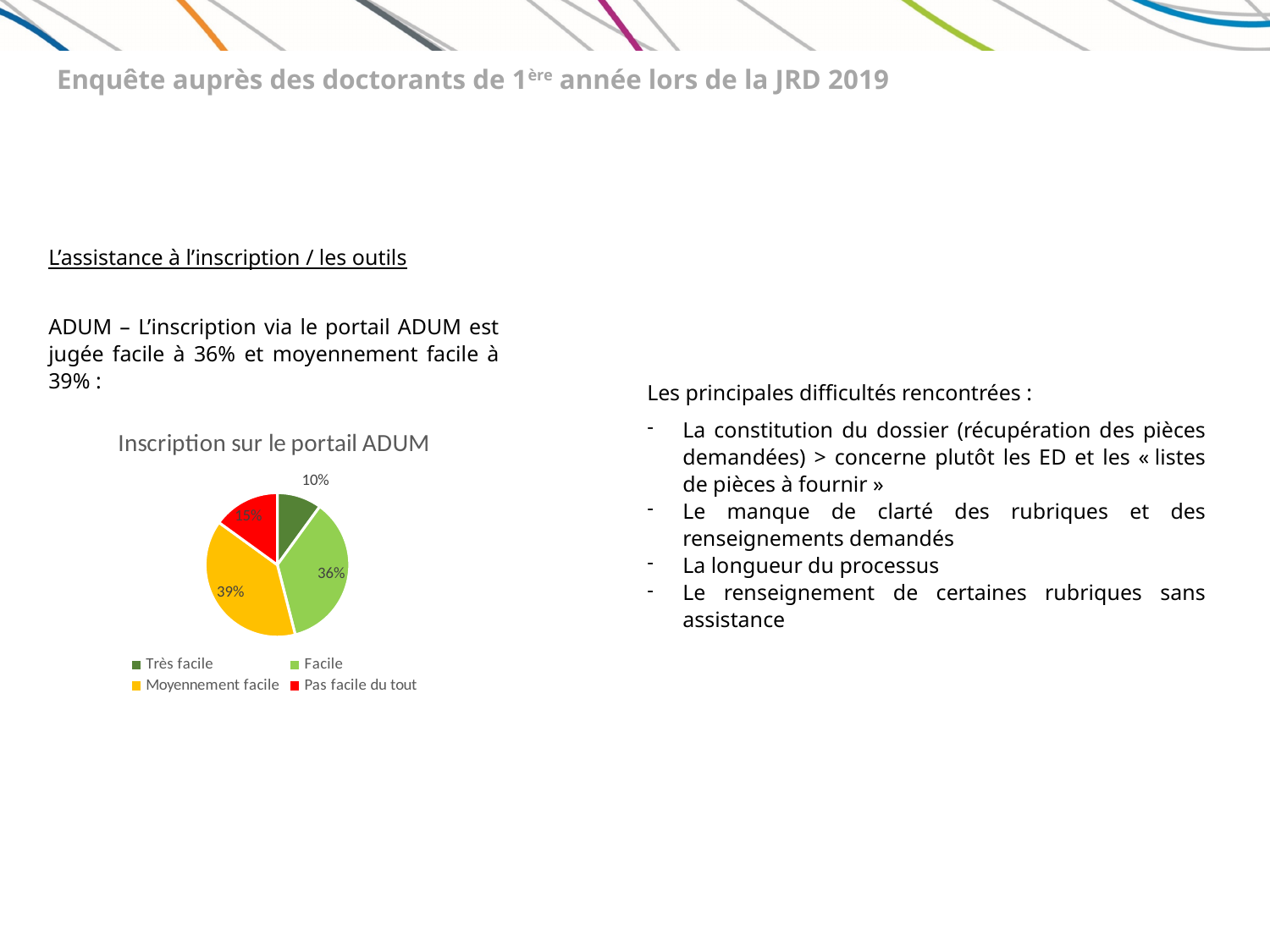
Which is larger, the share for "Pas facile du tout" or the share for "Très facile"? Pas facile du tout What kind of chart is shown on the slide? pie chart What is the value shown for "Très facile"? 10% Which category has the largest slice of the pie? Moyennement facile What share of the pie does "Facile" represent? 36% What is the difference between the "Moyennement facile" and "Facile" shares? 3% What share of the pie does "Moyennement facile" represent? 39% Which category has the smallest slice of the pie? Très facile Which colour represents "Pas facile du tout" in the legend? red What is the value shown for "Pas facile du tout"? 15% What is the title of the chart? Inscription sur le portail ADUM How many categories does the pie chart have? 4